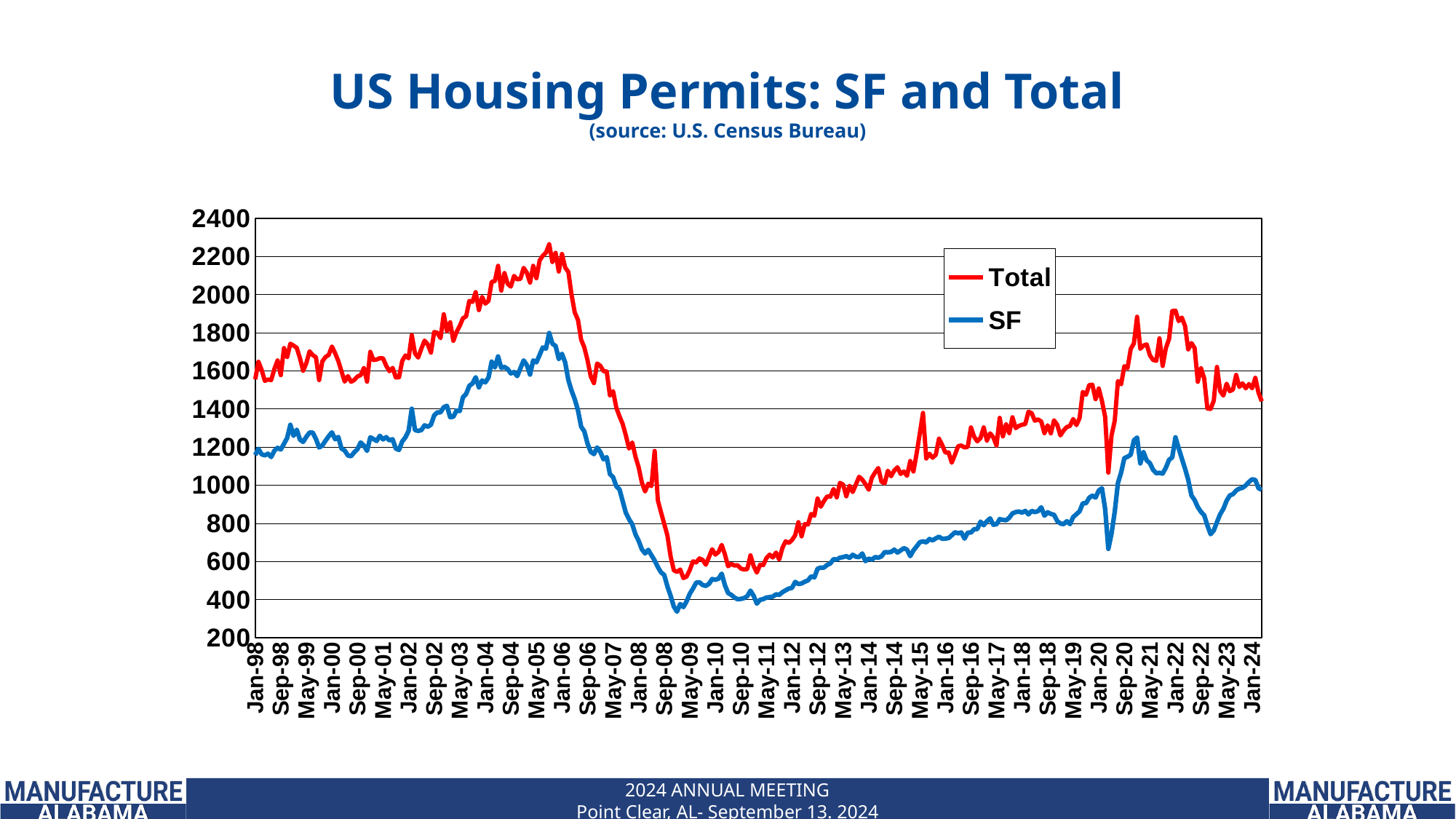
Is the value for SF at Jan-98 greater or less than 1400? less What are the two series named in the legend? Total and SF What is the title of the chart? US Housing Permits: SF and Total Which series is larger at Jan-24, Total or SF? Total What kind of chart is shown on the slide? line chart Is the value for SF at May-09 greater or less than 600? less How many series does the legend list? 2 Is the value for Total at Jan-22 greater or less than 1600? greater Does the SF series rise or fall between Jan-12 and Jan-18? rise Does the Total series rise or fall between Jan-06 and Jan-09? fall